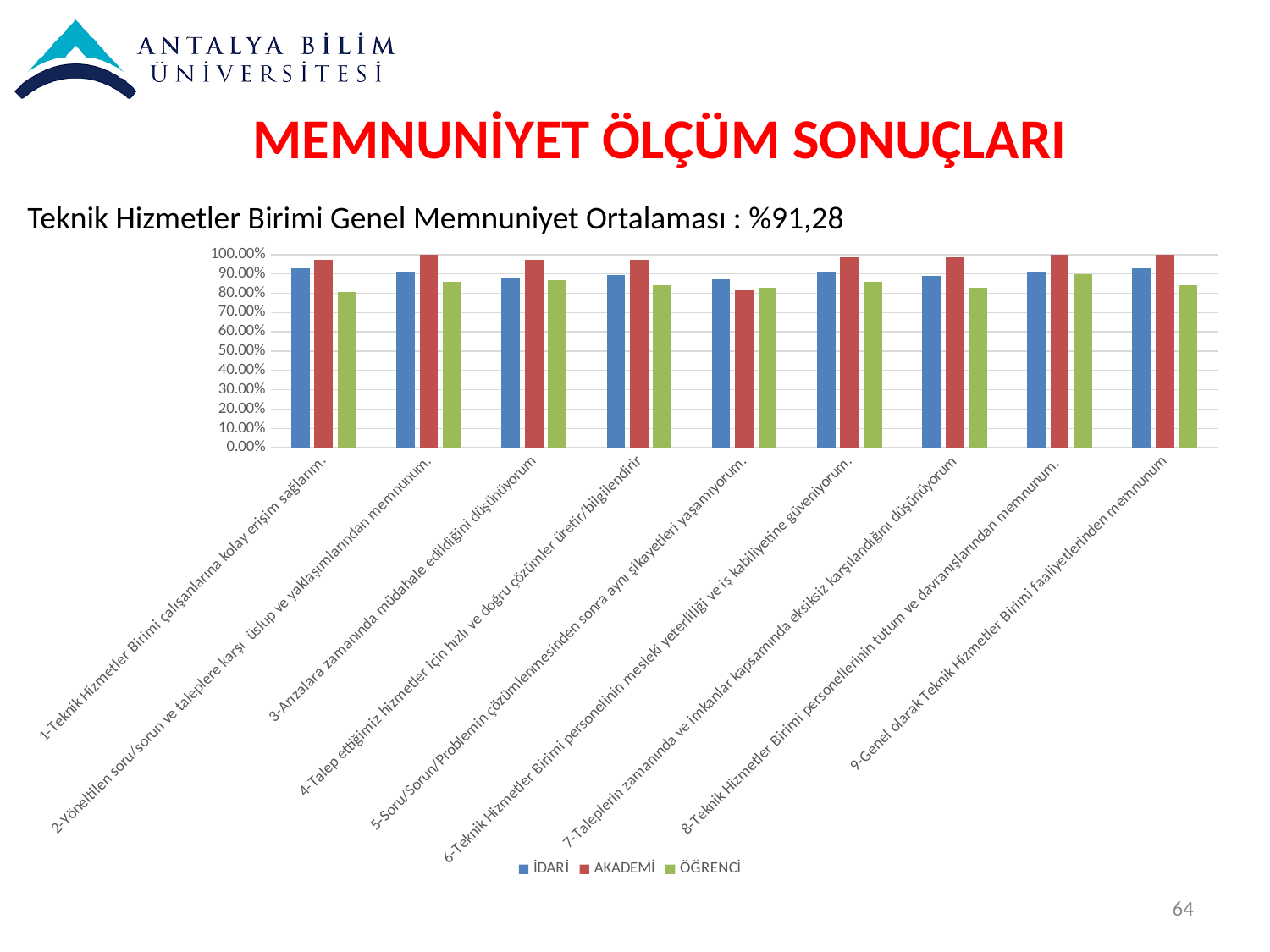
Is the AKADEMİ value for category 2 (Yöneltilen soru/sorun ve taleplere karşı üslup ve yaklaşımlarından memnunum) greater or less than 90.00%? greater How many categories (questions) are plotted along the x axis? 9 In which category is the AKADEMİ value the lowest? 5-Soru/Sorun/Problemin çözümlenmesinden sonra aynı şikayetleri yaşamıyorum Which series does the legend show in red? AKADEMİ Is the AKADEMİ value for category 5 (Soru/Sorun/Problemin çözümlenmesinden sonra aynı şikayetleri yaşamıyorum) greater or less than 90.00%? less Is the ÖĞRENCİ value for category 1 (Teknik Hizmetler Birimi çalışanlarına kolay erişim sağlarım) greater or less than 90.00%? less How many series does the legend list? 3 For category 5 (Soru/Sorun/Problemin çözümlenmesinden sonra aynı şikayetleri yaşamıyorum), which is larger: the İDARİ value or the AKADEMİ value? İDARİ What is the Teknik Hizmetler Birimi Genel Memnuniyet Ortalaması stated on the slide? %91,28 For category 1 (Teknik Hizmetler Birimi çalışanlarına kolay erişim sağlarım), which series has the highest value? AKADEMİ What kind of chart is shown on the slide? bar chart